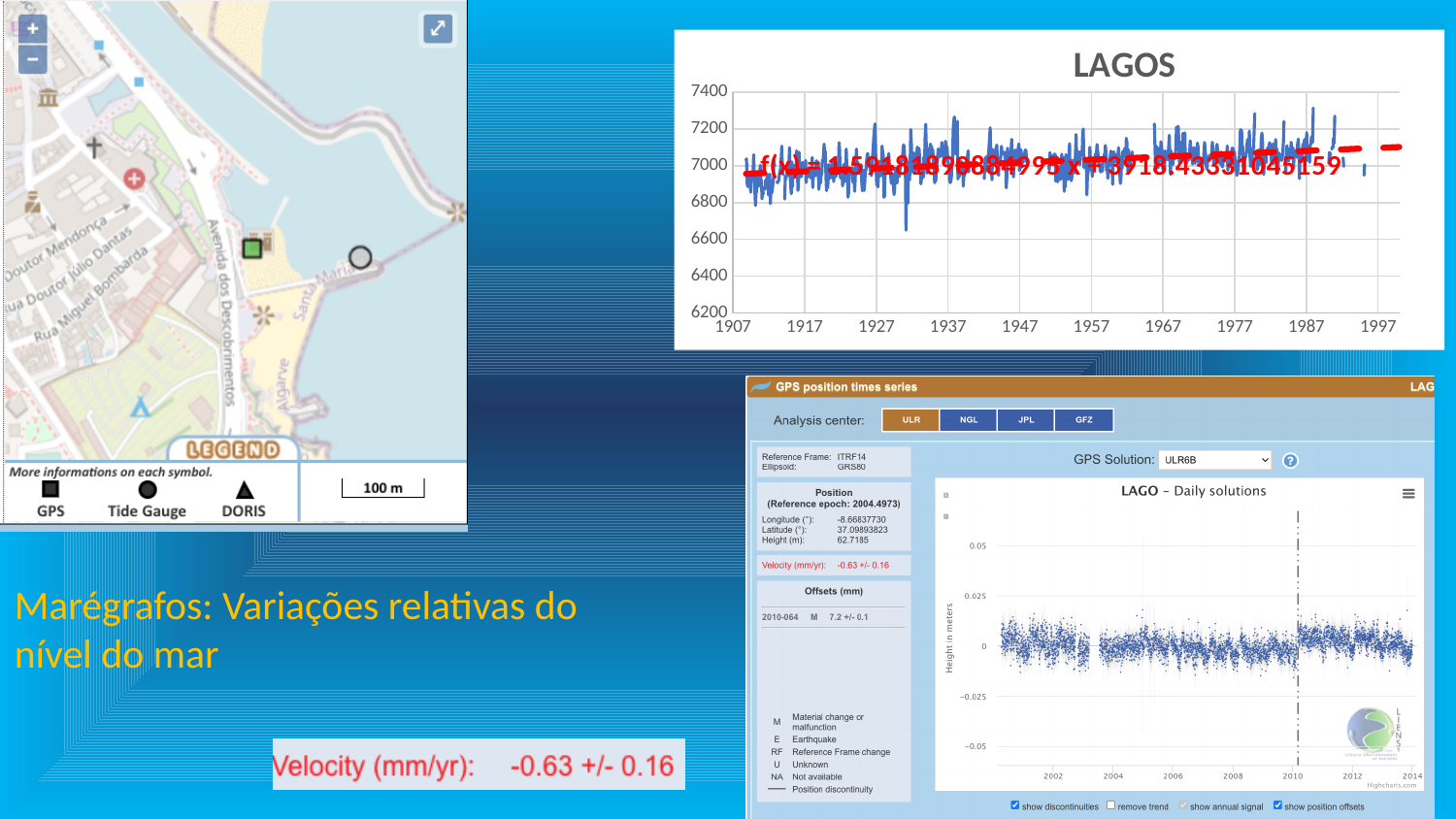
In the LAGOS chart, what is the last year label on the x axis? 1997 In the LAGOS chart, does the dashed red trend line rise or fall from 1907 to 1997? rise What kind of chart is the LAGOS chart? line chart What is the title of the chart in the GPS position time series panel at the bottom right? LAGO – Daily solutions What is the title of the chart at the top right of the slide? LAGOS In the LAGO – Daily solutions chart, what is the label of the y axis? Height in meters In the LAGOS chart, what is the highest value shown on the y axis? 7400 In the LAGOS chart, what is the lowest value shown on the y axis? 6200 In the LAGOS chart, what is the first year label on the x axis? 1907 In the LAGO – Daily solutions chart, what is the last year label on the x axis? 2014 In the LAGOS chart, are the plotted values around 1987 greater or less than 6600? greater What velocity (mm/yr) is reported for the GPS position time series on the slide? -0.63 +/- 0.16